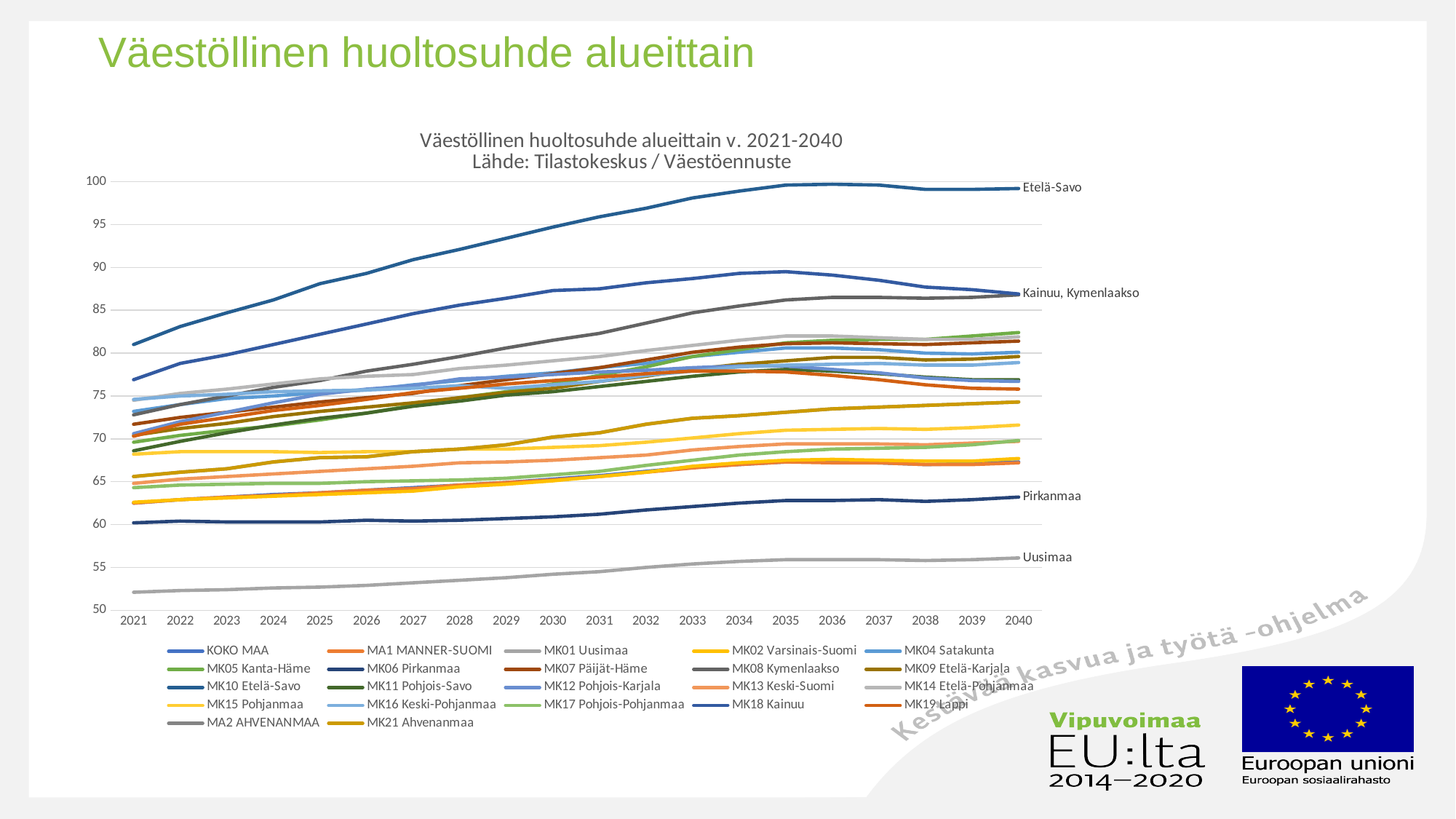
Is the value for Etelä-Savo in 2040 greater or less than 95? greater What kind of chart is shown on the slide? line chart What is the title of the chart? Väestöllinen huoltosuhde alueittain v. 2021-2040 Lähde: Tilastokeskus / Väestöennuste Is the value for Uusimaa in 2021 greater or less than 55? less Which region has the highest dependency ratio line across the whole period? Etelä-Savo Is the value for Uusimaa in 2040 greater or less than 55? greater Does the Etelä-Savo line rise or fall between 2021 and 2035? rise How many years are shown along the x axis? 20 How many series does the legend list? 22 Which is larger in 2040, the value for Etelä-Savo or the value for Pirkanmaa? Etelä-Savo Which region has the lowest dependency ratio line across the whole period? Uusimaa